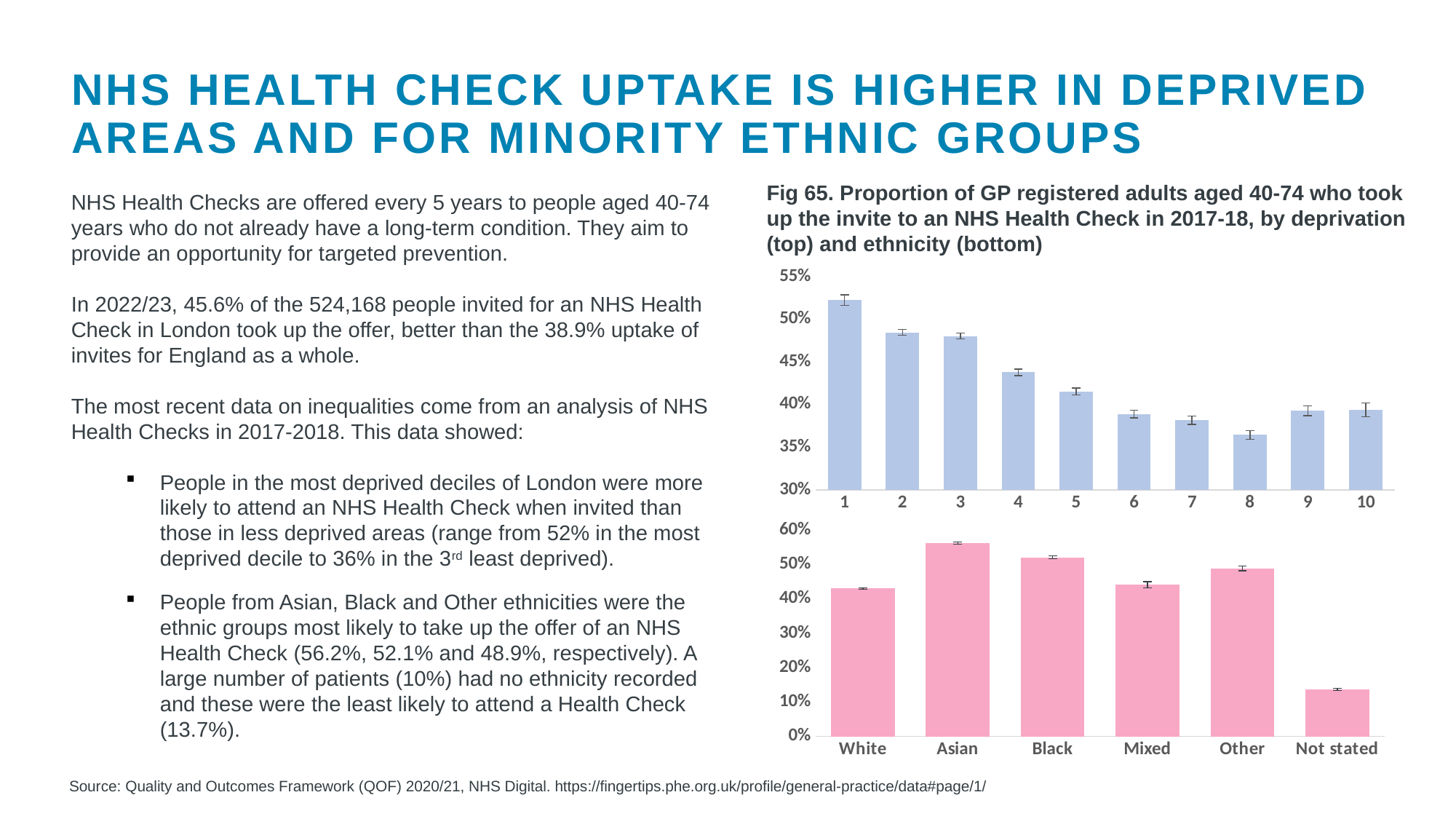
On the top chart (by deprivation decile), is the value for decile 4 greater or less than 45%? less On the top chart (by deprivation decile), which decile has the lowest uptake? 8 On the bottom chart (by ethnicity), which is larger, the value for Black or the value for White? Black On the bottom chart (by ethnicity), which ethnic group has the highest uptake? Asian On the bottom chart (by ethnicity), which category has the lowest uptake? Not stated On the top chart (by deprivation decile), which decile has the highest uptake? 1 On the top chart (by deprivation decile), is the value for decile 1 greater or less than 50%? greater What type of chart is the bottom chart (by ethnicity)? bar chart On the top chart (by deprivation decile), do the values generally rise or fall from decile 1 to decile 8? fall On the top chart (by deprivation decile), is the value for decile 8 greater or less than 40%? less On the top chart (by deprivation decile), how many deciles are plotted? 10